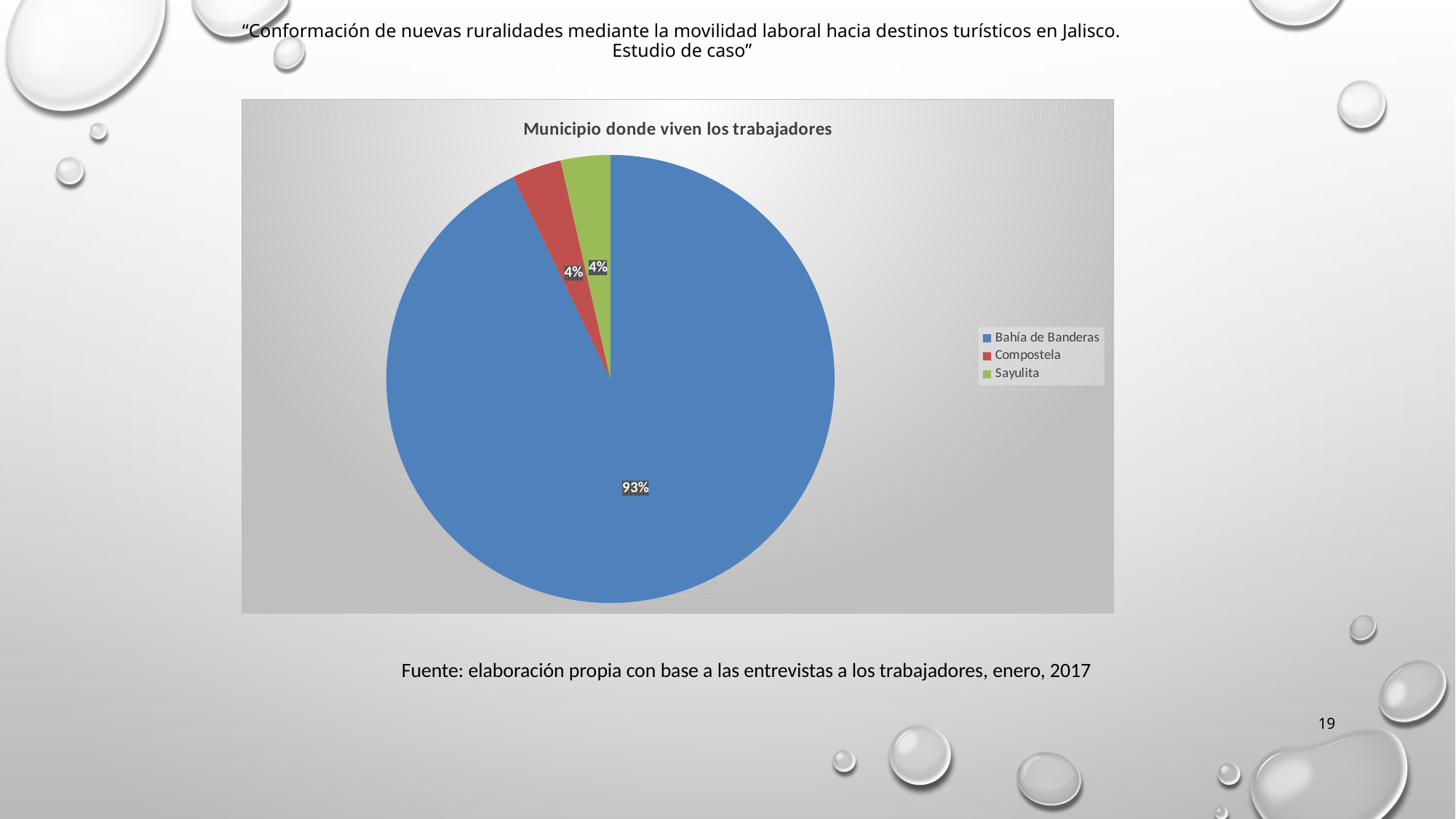
Is the share for Bahía de Banderas greater or less than 50%? greater What share of the pie does Bahía de Banderas represent? 93% What is the difference between the share for Bahía de Banderas and the share for Sayulita? 89% Which colour represents Sayulita in the chart? green What share of the pie does Sayulita represent? 4% Which municipality has the largest slice of the pie? Bahía de Banderas What share of the pie does Compostela represent? 4% What kind of chart is shown on the slide? pie chart How many categories does the legend list? 3 Which is larger, the slice for Bahía de Banderas or the slice for Compostela? Bahía de Banderas What is the title of the chart? Municipio donde viven los trabajadores